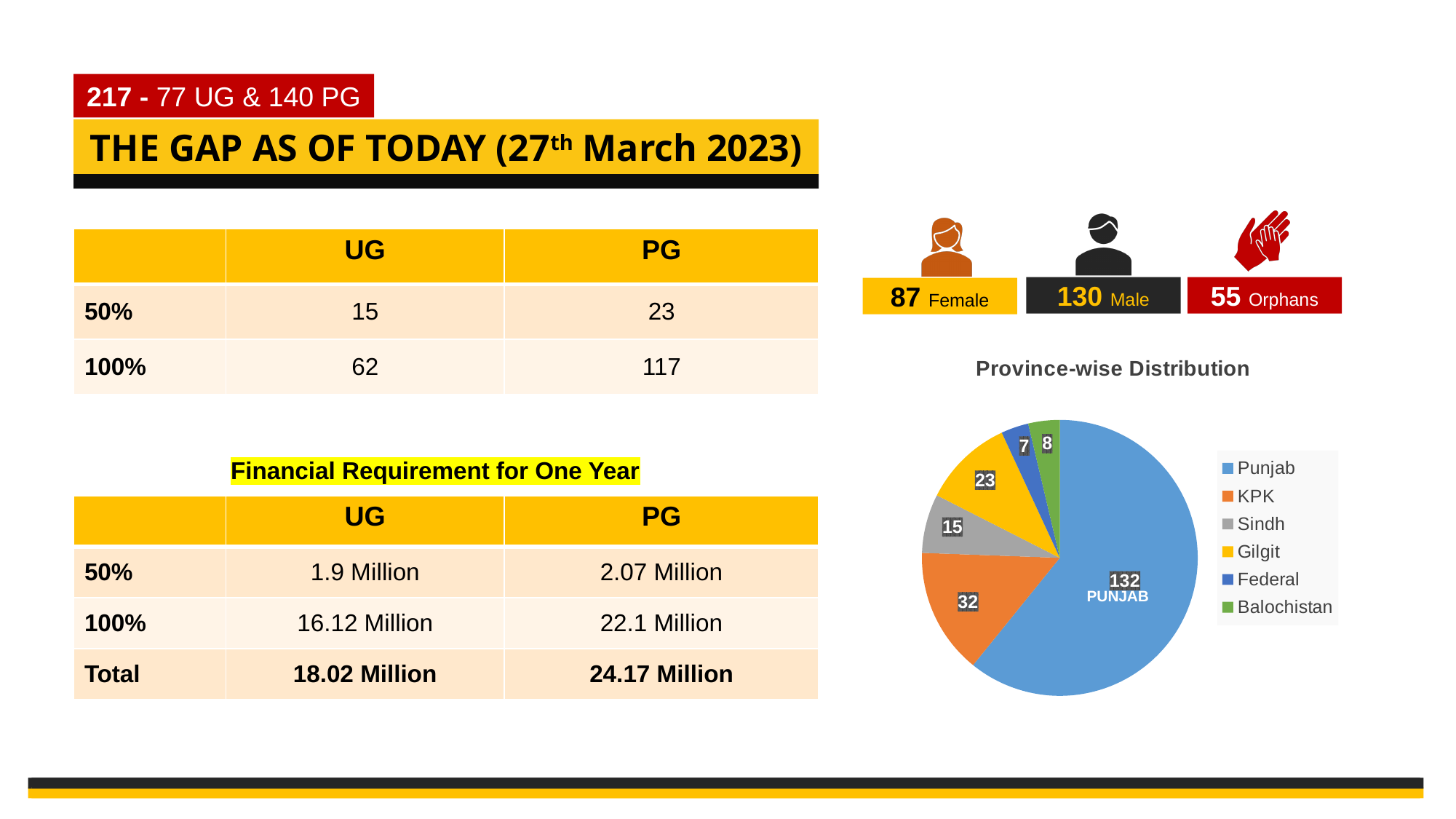
What kind of chart is the Province-wise Distribution chart? Pie chart In the Province-wise Distribution pie chart, what is the value for Punjab? 132 In the Province-wise Distribution pie chart, what is the value for Federal? 7 In the Province-wise Distribution pie chart, what is the value for Gilgit? 23 In the Province-wise Distribution pie chart, what is the value for Sindh? 15 How many categories does the Province-wise Distribution pie chart show? 6 Which province has the largest slice in the Province-wise Distribution pie chart? Punjab In the Province-wise Distribution pie chart, what is the value for KPK? 32 Which category has the smallest slice in the Province-wise Distribution pie chart? Federal In the Province-wise Distribution pie chart, which is larger, Gilgit or Sindh? Gilgit In the Province-wise Distribution pie chart, what is the difference between the values for KPK and Sindh? 17 In the Province-wise Distribution pie chart, what is the value for Balochistan? 8